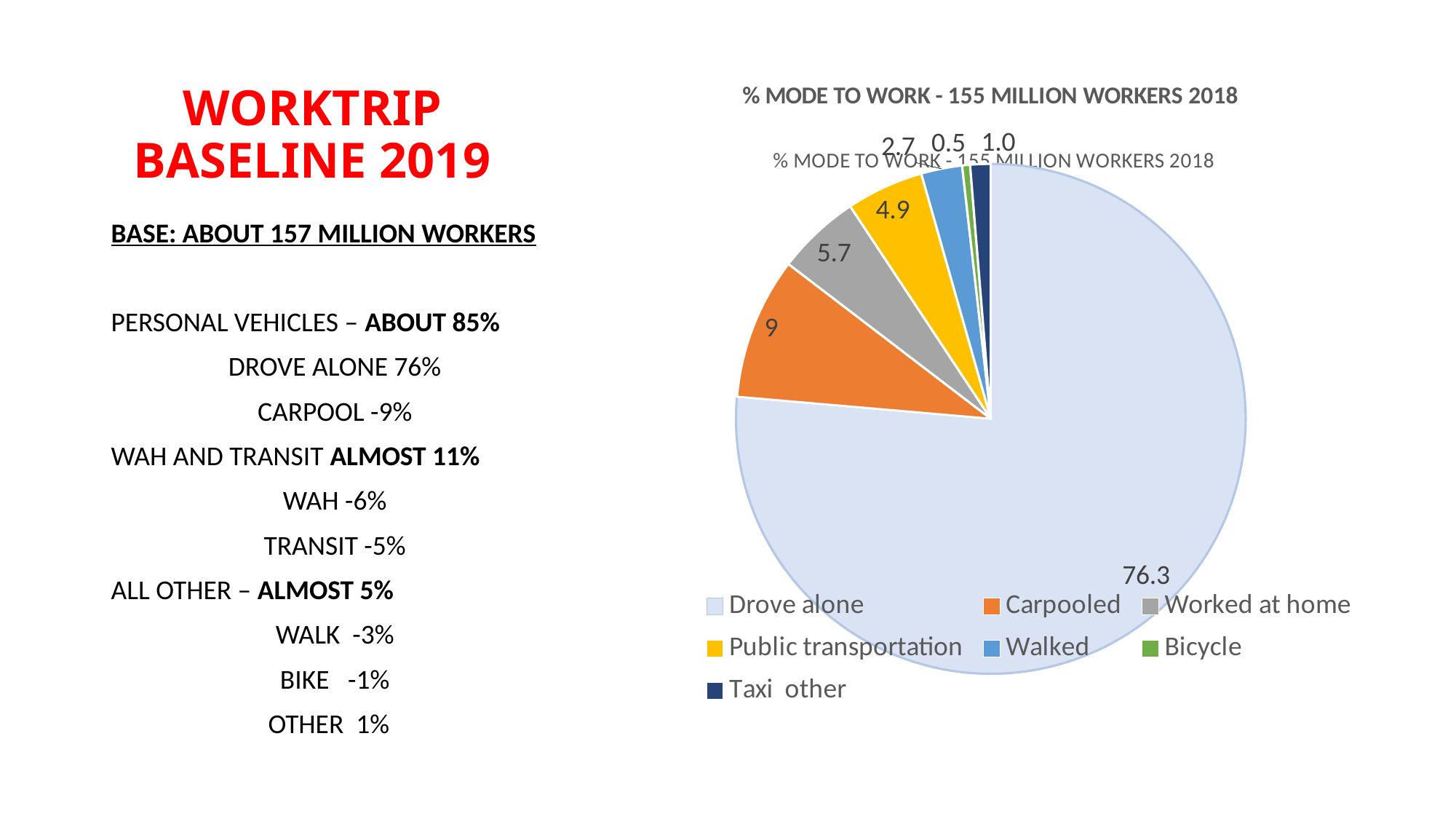
What is the title of the chart? % MODE TO WORK - 155 MILLION WORKERS 2018 Which category has the largest slice of the pie? Drove alone What is the value shown for Worked at home? 5.7 What is the difference between the values for Carpooled and Worked at home? 3.3 What is the value shown for Walked? 2.7 What is the value shown for Public transportation? 4.9 What type of chart is shown on the slide? Pie chart What is the value shown for Drove alone? 76.3 Which category has the smallest slice of the pie? Bicycle How many categories does the legend list? 7 Which is larger, the value for Taxi other or the value for Bicycle? Taxi other What is the value shown for Carpooled? 9